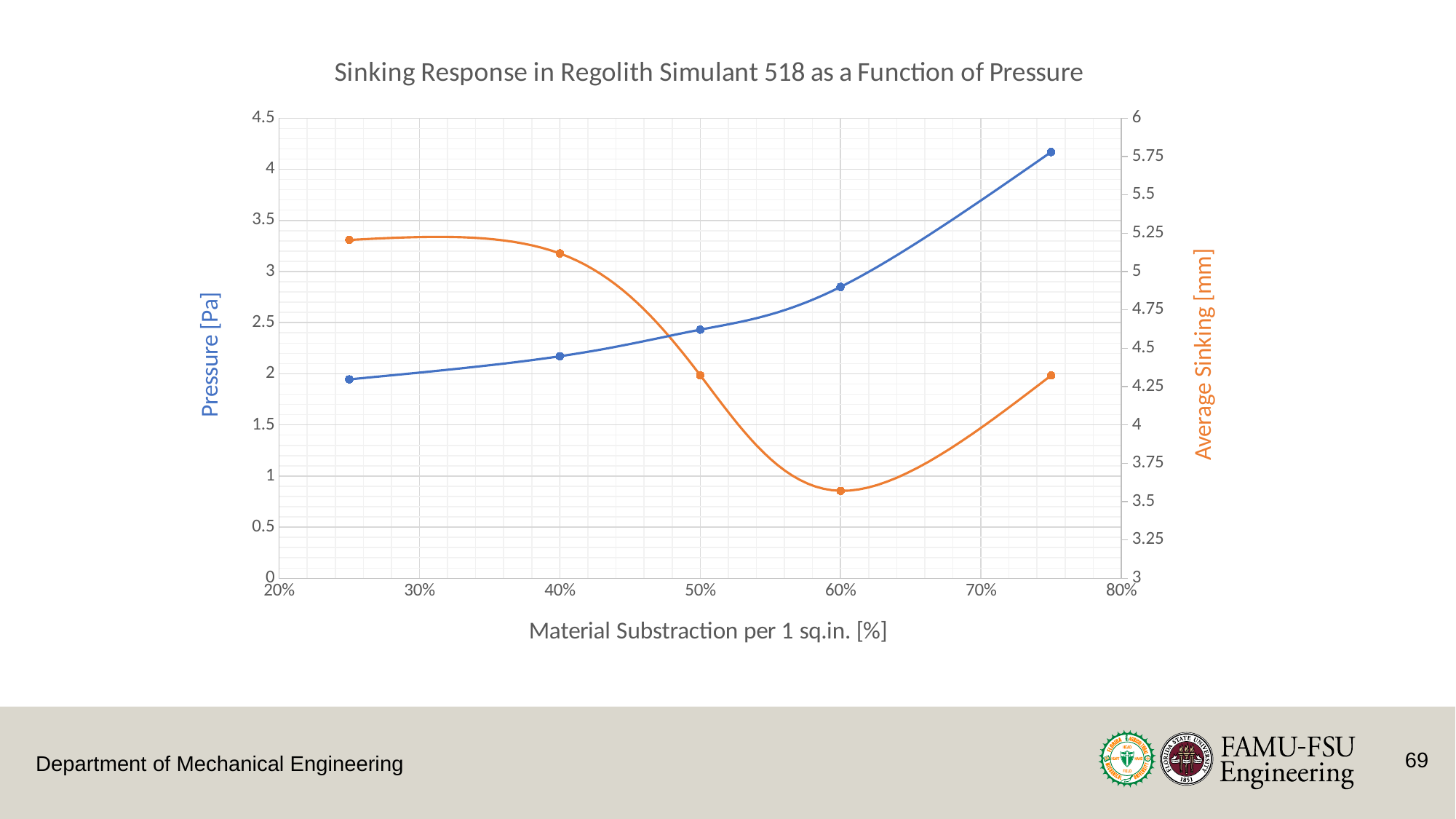
How many data points does the Pressure [Pa] series have? 5 What is the label of the x axis? Material Substraction per 1 sq.in. [%] At which Material Substraction value is Average Sinking [mm] lowest? 60% What is the title of the chart? Sinking Response in Regolith Simulant 518 as a Function of Pressure At which Material Substraction value is Pressure [Pa] highest? 75% Does the Pressure [Pa] series rise or fall as Material Substraction increases from 25% to 75%? rise Is the Pressure [Pa] value at 75% greater or less than 4? greater What kind of chart is shown on the slide? line chart Which is larger, the Average Sinking [mm] value at 25% or at 50%? 25% At which Material Substraction value is Pressure [Pa] lowest? 25% Is the Average Sinking [mm] value at 60% greater or less than 3.75? less Is the Average Sinking [mm] value at 25% greater or less than 5? greater